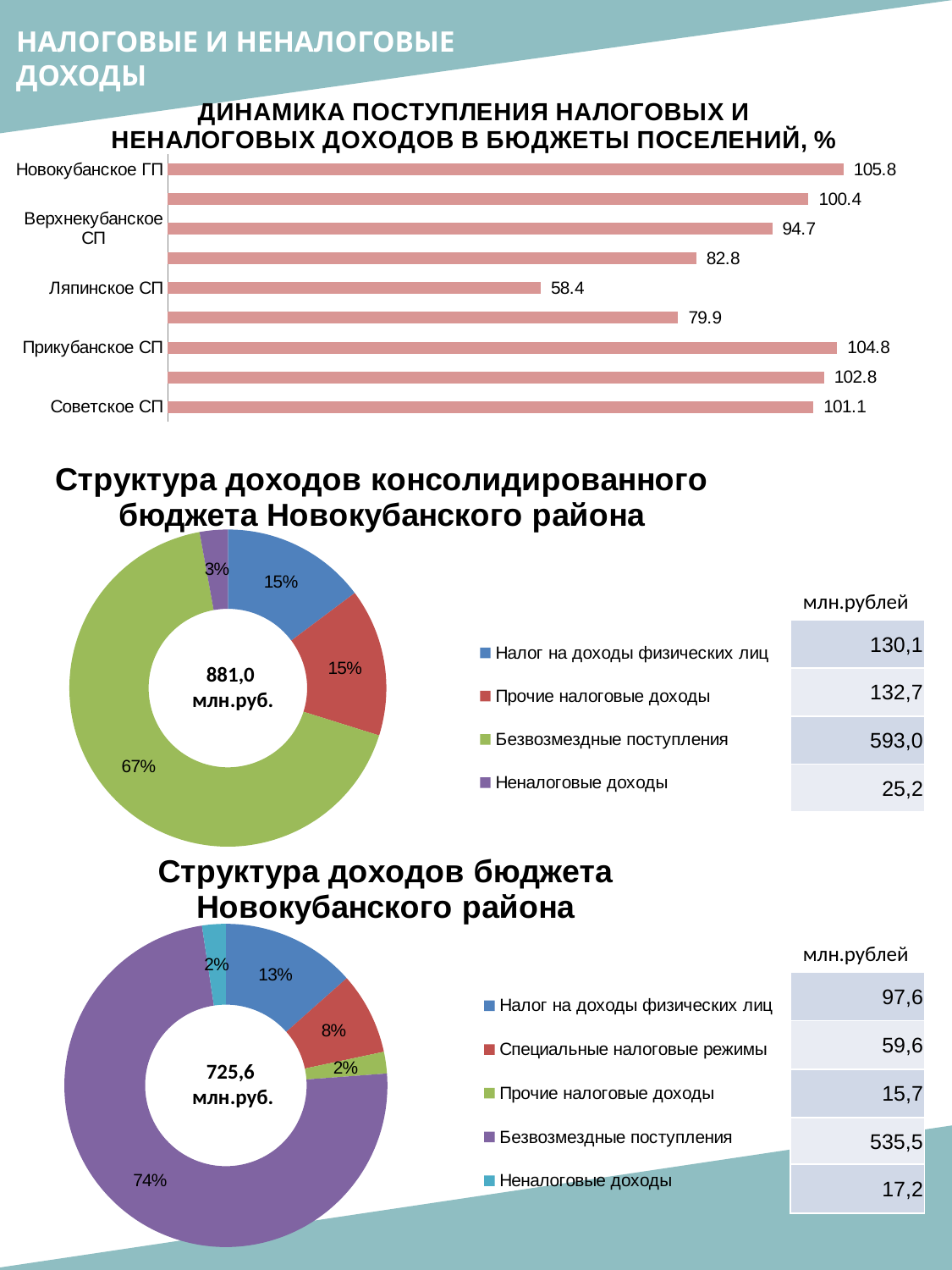
In the bar chart 'Динамика поступления налоговых и неналоговых доходов в бюджеты поселений, %', what is the value for Ляпинское СП? 58.4 In the bar chart 'Динамика поступления налоговых и неналоговых доходов в бюджеты поселений, %', which labelled settlement has the lowest value? Ляпинское СП How many categories does the legend of the chart 'Структура доходов бюджета Новокубанского района' list? 5 What type of chart is 'Структура доходов консолидированного бюджета Новокубанского района'? Pie (doughnut) chart In the chart 'Структура доходов консолидированного бюджета Новокубанского района', what is the value in млн.рублей for Прочие налоговые доходы? 132,7 In the chart 'Структура доходов консолидированного бюджета Новокубанского района', what share do Безвозмездные поступления have? 67% In the bar chart 'Динамика поступления налоговых и неналоговых доходов в бюджеты поселений, %', what is the difference between the values for Новокубанское ГП and Ляпинское СП? 47.4 In the bar chart 'Динамика поступления налоговых и неналоговых доходов в бюджеты поселений, %', which is larger: the value for Прикубанское СП or for Советское СП? Прикубанское СП In the chart 'Структура доходов бюджета Новокубанского района', what is the value in млн.рублей for Специальные налоговые режимы? 59,6 In the bar chart 'Динамика поступления налоговых и неналоговых доходов в бюджеты поселений, %', what is the highest value shown? 105.8 In the bar chart 'Динамика поступления налоговых и неналоговых доходов в бюджеты поселений, %', what is the value for Новокубанское ГП? 105.8 In the bar chart 'Динамика поступления налоговых и неналоговых доходов в бюджеты поселений, %', how many bars are plotted? 9